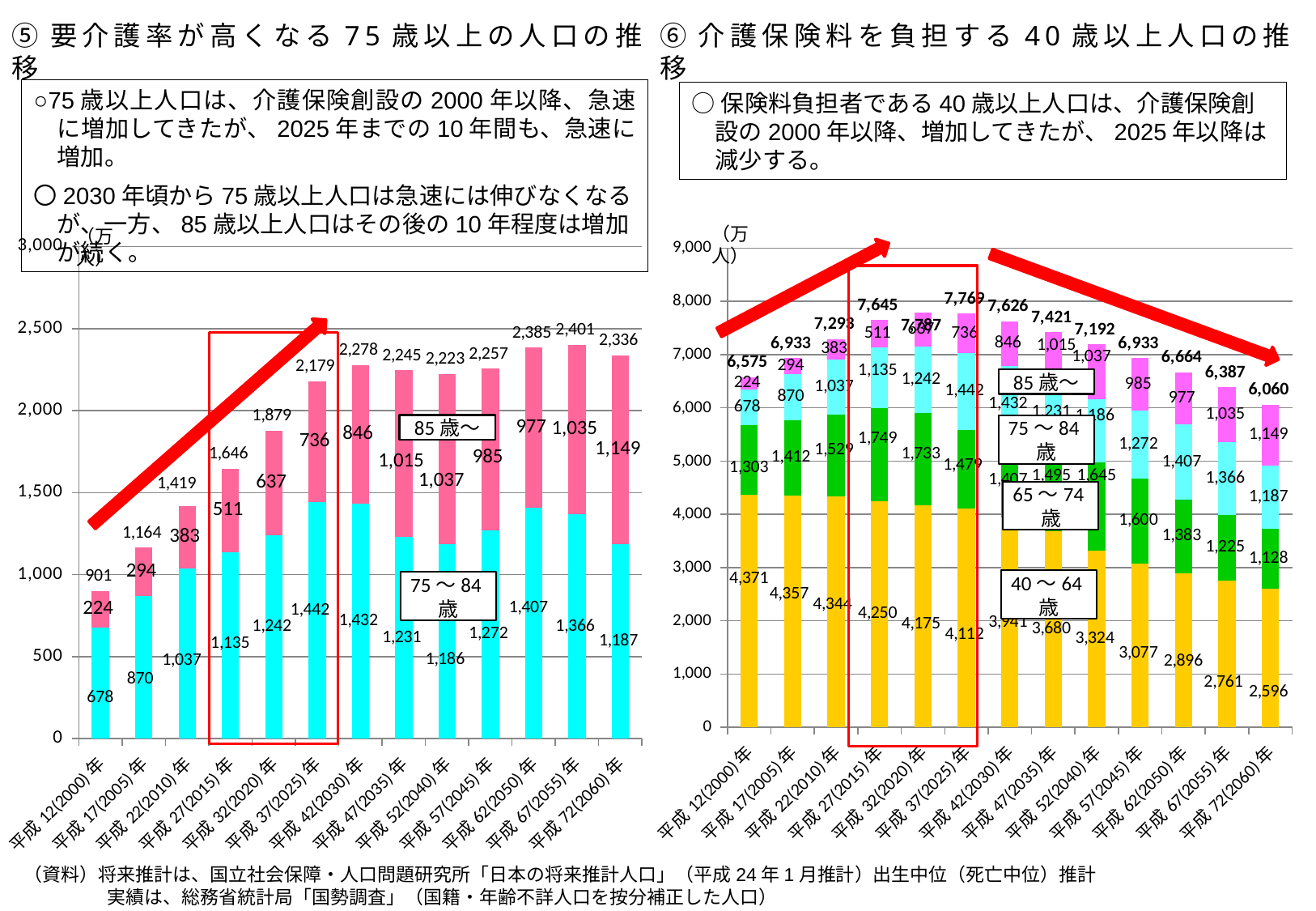
In the left chart (⑤ 75歳以上の人口の推移), how many years are shown on the x axis? 13 In the left chart (⑤ 75歳以上の人口の推移), which year has the highest total? 平成67(2055)年 In the left chart (⑤ 75歳以上の人口の推移), what is the total value labeled above the bar for 平成37(2025)年? 2,179 In the left chart (⑤ 75歳以上の人口の推移), what kind of chart is used? Stacked bar chart In the left chart (⑤ 75歳以上の人口の推移), which year has the lowest total? 平成12(2000)年 In the right chart (⑥ 40歳以上人口の推移), is the total for 平成12(2000)年 larger or smaller than the total for 平成57(2045)年? Smaller In the right chart (⑥ 40歳以上人口の推移), what is the total value labeled above the bar for 平成32(2020)年? 7,787 In the right chart (⑥ 40歳以上人口の推移), which year has the lowest total? 平成72(2060)年 In the right chart (⑥ 40歳以上人口の推移), what is the 40～64歳 value for 平成72(2060)年? 2,596 In the right chart (⑥ 40歳以上人口の推移), how many age-group segments make up each bar? 4 In the left chart (⑤ 75歳以上の人口の推移), what is the difference between the 75～84歳 value and the 85歳～ value for 平成12(2000)年? 454 In the left chart (⑤ 75歳以上の人口の推移), what is the 85歳～ value for 平成22(2010)年? 383